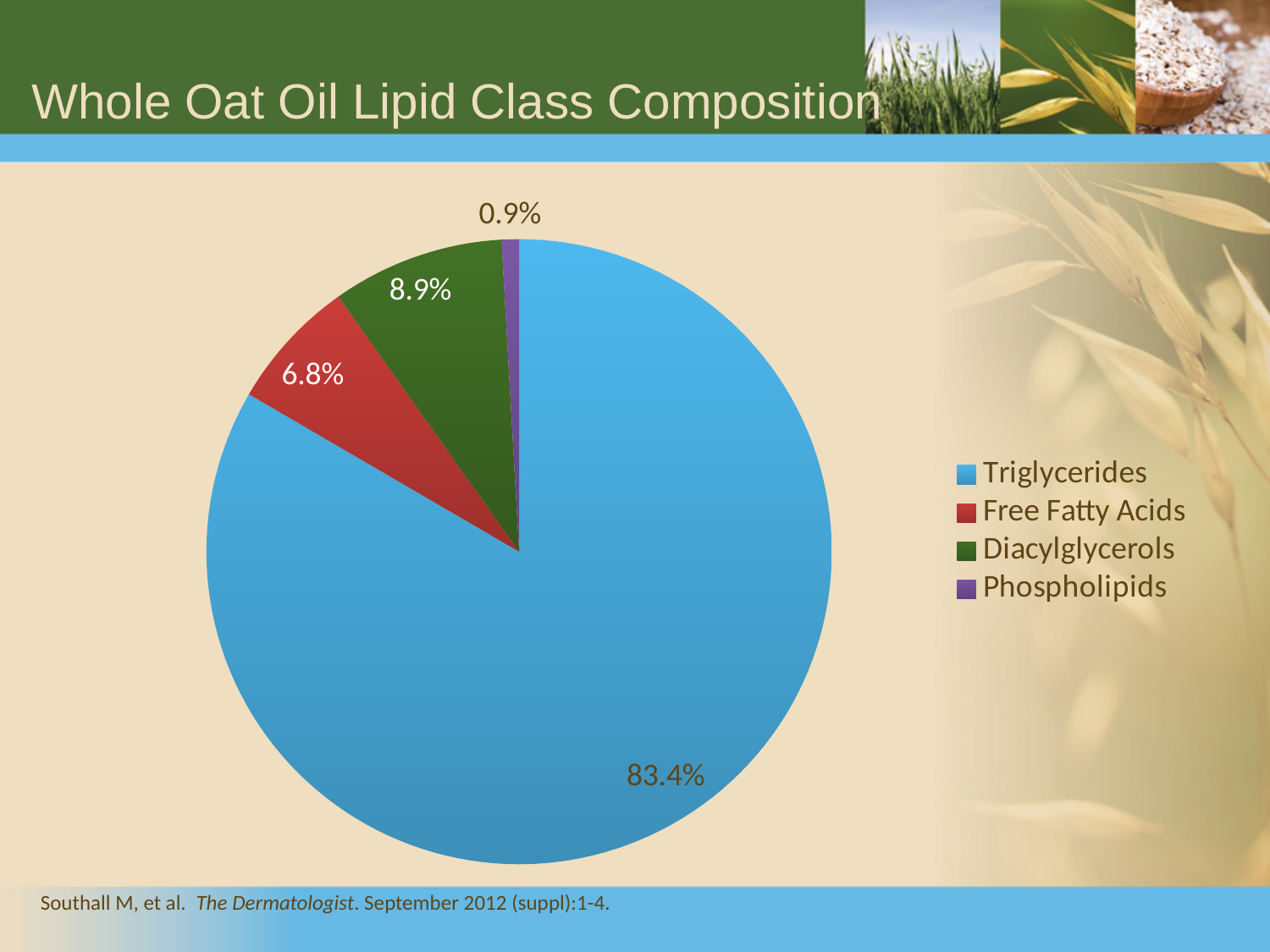
Which lipid class makes up the largest share of whole oat oil? Triglycerides Which lipid class makes up the smallest share of whole oat oil? Phospholipids What percentage of whole oat oil is Free Fatty Acids? 6.8% What is the title of the slide? Whole Oat Oil Lipid Class Composition What percentage of whole oat oil is Phospholipids? 0.9% What percentage of whole oat oil is Diacylglycerols? 8.9% What type of chart is shown on the slide? pie chart How many lipid classes are shown in the pie chart? 4 What colour represents Free Fatty Acids in the pie chart? red What percentage of whole oat oil is Triglycerides? 83.4% What is the difference between the Diacylglycerols share and the Free Fatty Acids share? 2.1% Which is larger, the share of Diacylglycerols or the share of Free Fatty Acids? Diacylglycerols